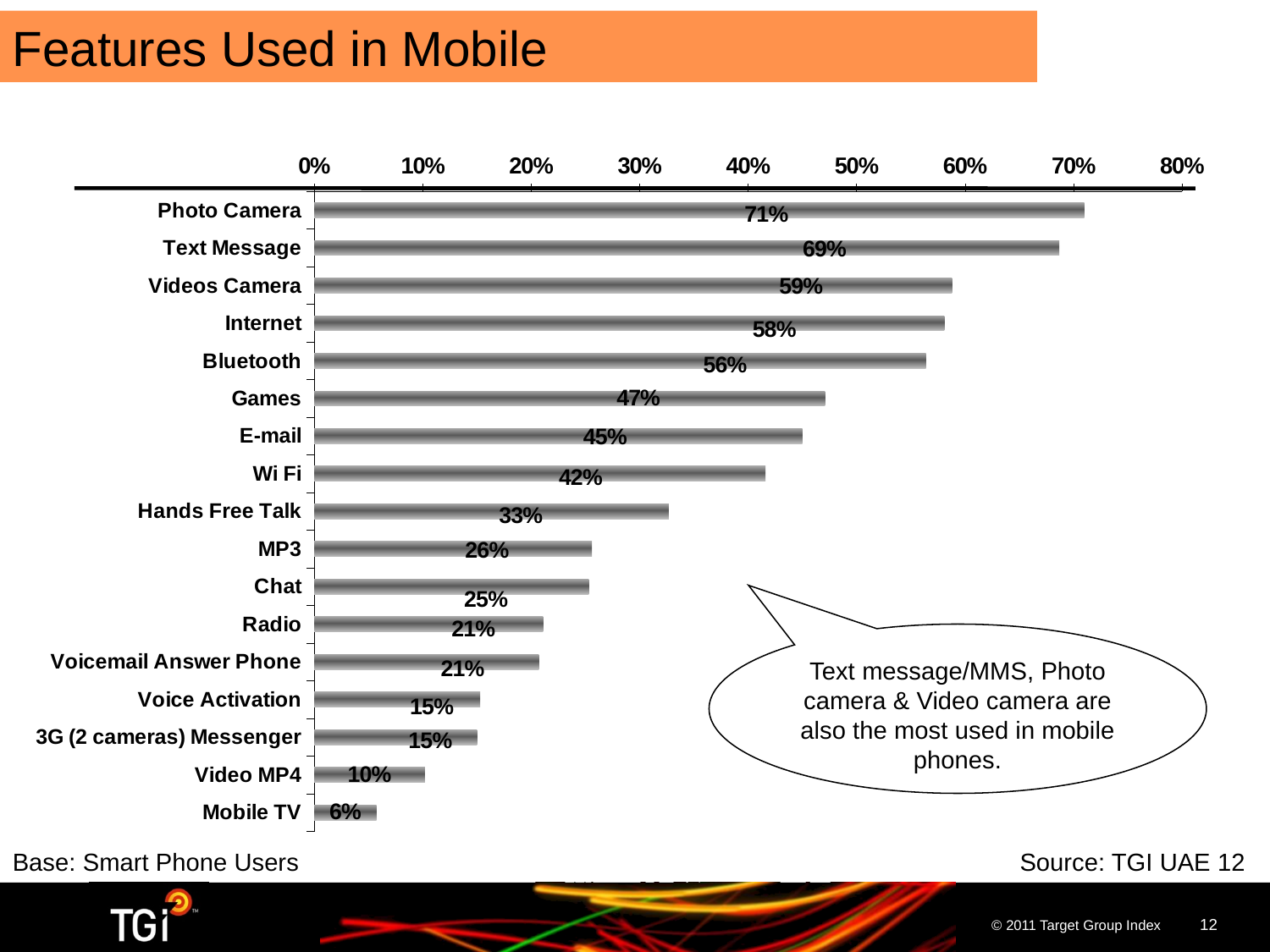
What is the value shown for Bluetooth? 56% What percentage of smart phone users use the Photo Camera feature? 71% What is the value shown for Hands Free Talk? 33% What kind of chart is shown on the slide? Bar chart What is the base of the data shown in the chart? Smart Phone Users Which feature has the lowest usage percentage? Mobile TV How many features are listed in the chart? 17 What is the title of the slide? Features Used in Mobile Is the value for Internet greater or less than 50%? greater Which feature has the highest usage percentage? Photo Camera What is the difference between the values for Text Message and Videos Camera? 10% Which is larger, the value for Games or the value for Wi Fi? Games